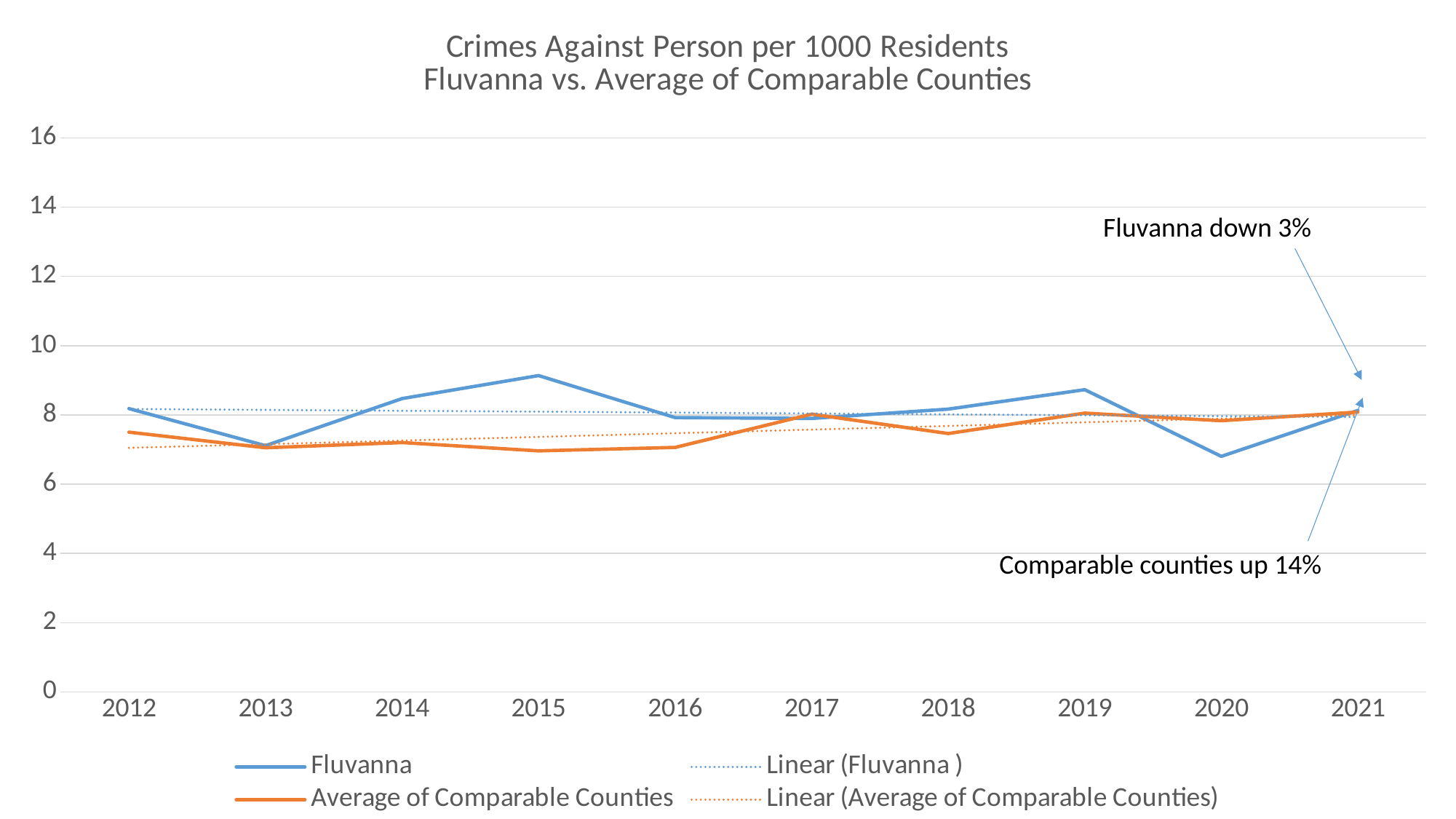
Is the Fluvanna value for 2015 greater or less than 8? greater In 2015, which series has the higher value, Fluvanna or Average of Comparable Counties? Fluvanna How many entries does the legend list? 4 What kind of chart is shown on the slide? line chart According to the annotation on the chart, by what percentage are comparable counties up? 14% Is the Average of Comparable Counties value for 2015 greater or less than 8? less Is the Fluvanna value for 2020 greater or less than 8? less In which year does the Fluvanna line reach its highest value? 2015 In which year does the Fluvanna line reach its lowest value? 2020 How many years are plotted along the x axis? 10 In 2020, which series has the higher value, Fluvanna or Average of Comparable Counties? Average of Comparable Counties Does the dotted linear trendline for Average of Comparable Counties rise or fall from 2012 to 2021? rise